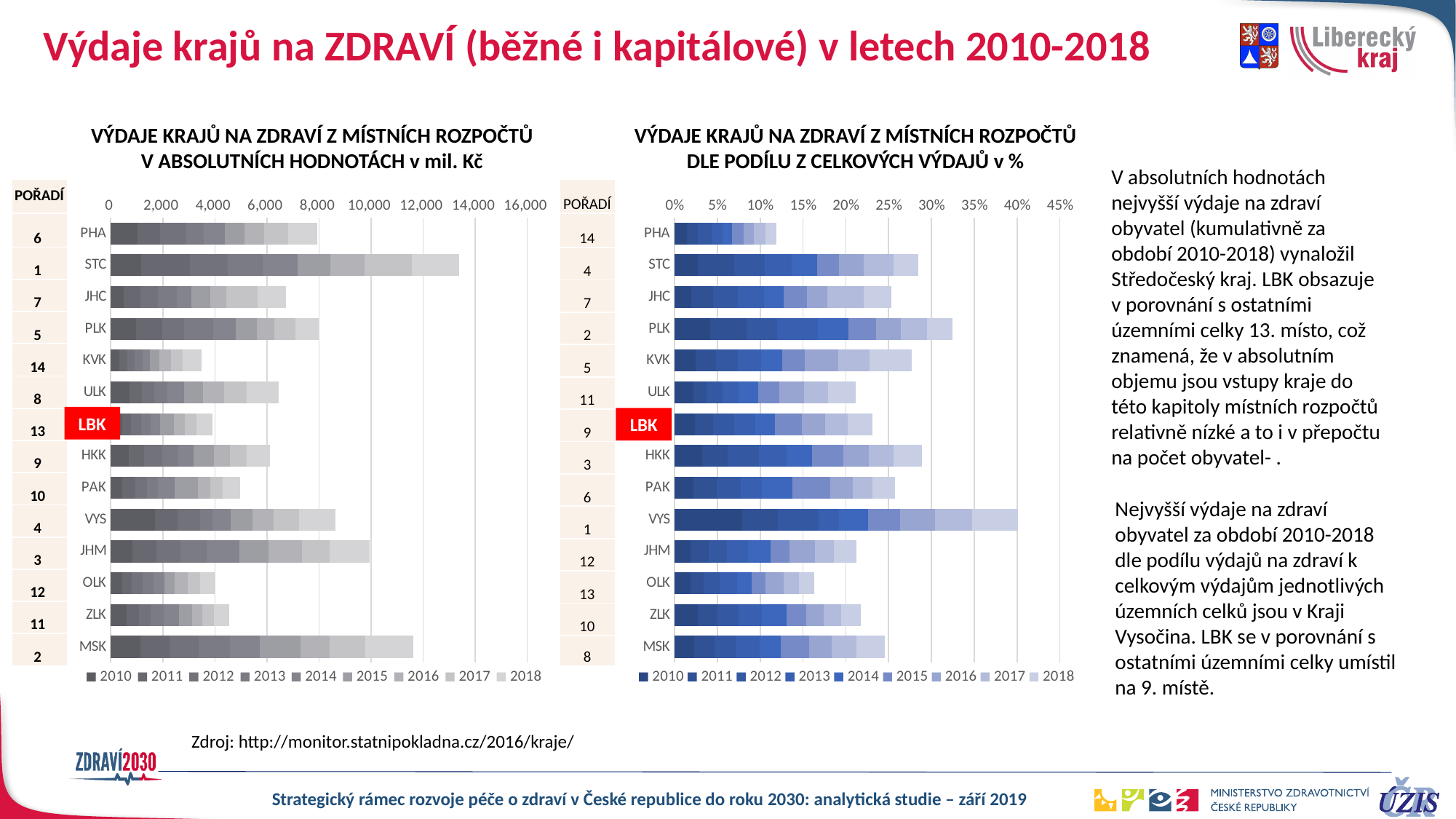
In the right chart (share of total expenditure in %), is the total value for LBK greater or less than 25%? less In the right chart (share of total expenditure in %), is the total value for VYS greater or less than 35%? greater In the left chart (absolute values in mil. Kč), is the total value for KVK greater or less than 4,000? less In the left chart (absolute values in mil. Kč), which region has the larger total: STC or MSK? STC What kind of chart is the left chart, 'VÝDAJE KRAJŮ NA ZDRAVÍ Z MÍSTNÍCH ROZPOČTŮ V ABSOLUTNÍCH HODNOTÁCH v mil. Kč'? Stacked bar chart How many series does the legend of the right chart (share of total expenditure in %) list? 9 According to the POŘADÍ column next to the left chart (absolute values in mil. Kč), what rank does LBK hold? 13 In the left chart (absolute values in mil. Kč), which region has the highest total expenditure? STC How many regions (categories) are plotted in the left chart (absolute values in mil. Kč)? 14 In the right chart (share of total expenditure in %), which region has the highest total share? VYS In the right chart (share of total expenditure in %), which region has the lowest total share? PHA